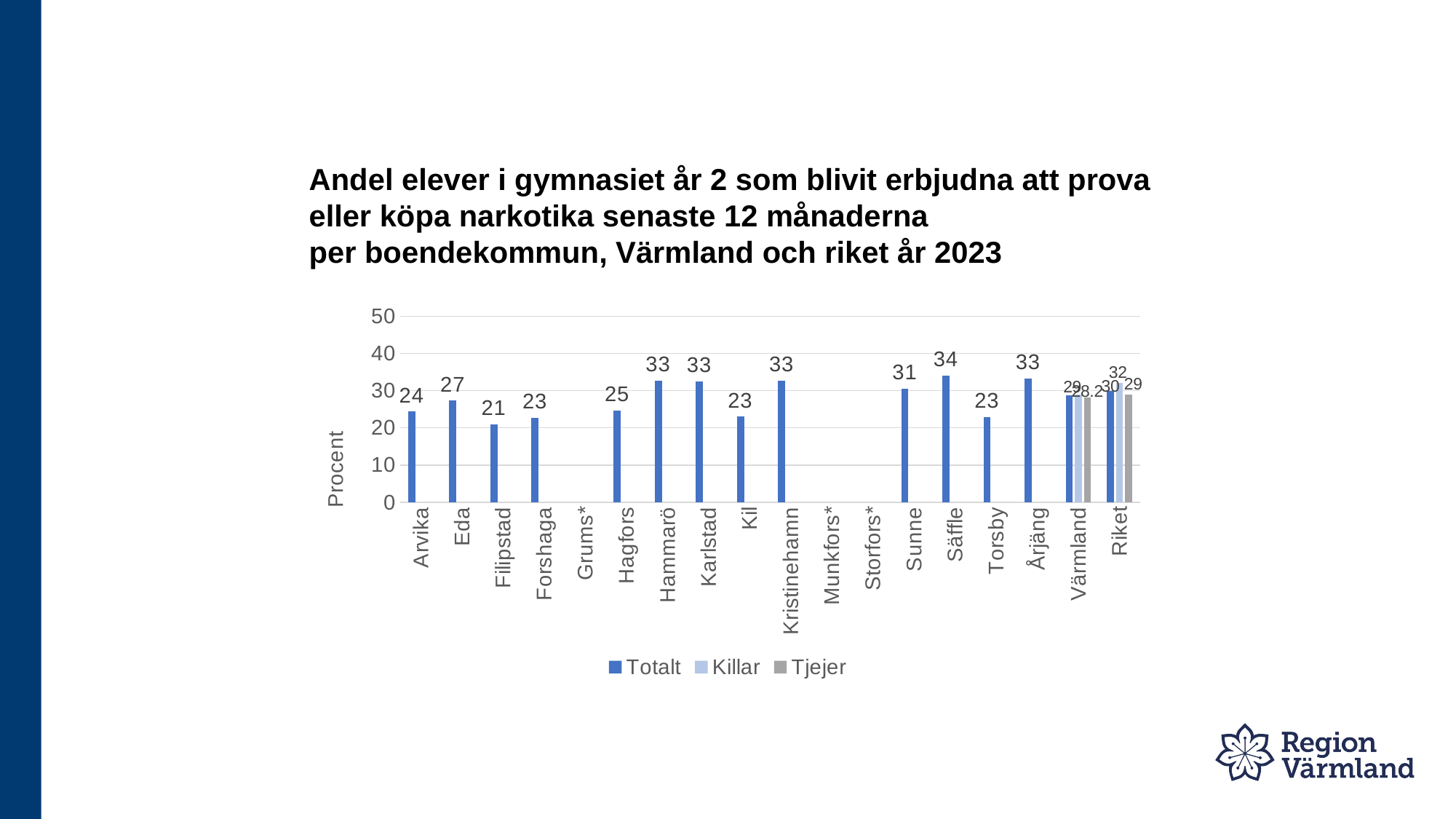
Which municipality with a plotted bar has the lowest Totalt value? Filipstad Which categories on the x axis are marked with an asterisk and have no bars? Grums, Munkfors, Storfors What is the Totalt value for Arvika? 24 How many series does the legend list? 3 What kind of chart is shown on the slide? bar chart How many categories are listed along the x axis? 18 What is the Totalt value for Säffle? 34 What is the difference between the Totalt values for Säffle and Filipstad? 13 What is the Tjejer value for Riket? 29 Which municipality has the highest Totalt value? Säffle Which has the larger Totalt value, Eda or Hagfors? Eda What is the Killar value for Riket? 32